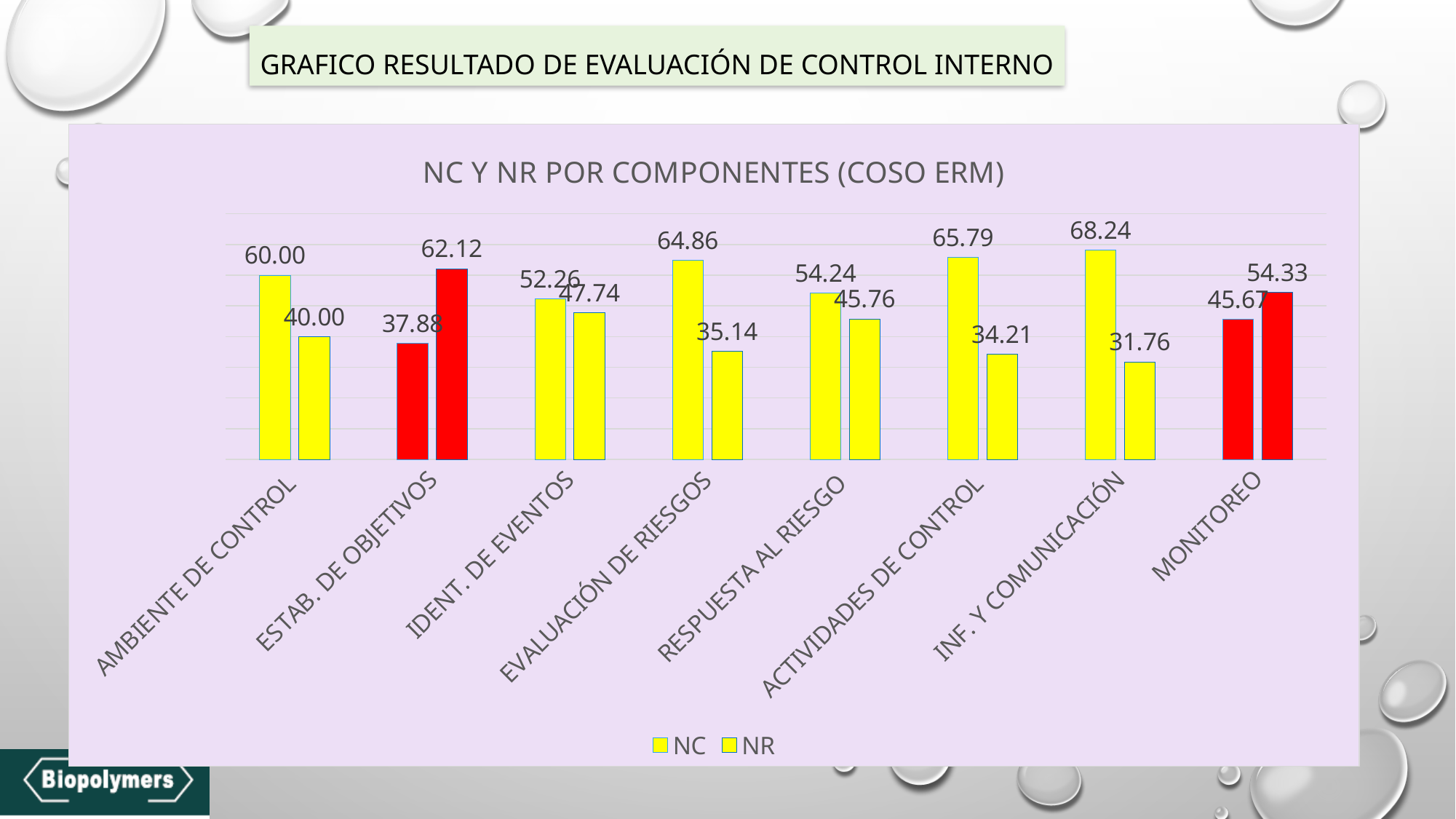
What is the NC value for MONITOREO? 45.67 Which component has the highest NC value? INF. Y COMUNICACIÓN How many components are shown on the x axis? 8 What is the NC value for AMBIENTE DE CONTROL? 60.00 Which component has the lowest NC value? ESTAB. DE OBJETIVOS What is the NR value for INF. Y COMUNICACIÓN? 31.76 Which component has the highest NR value? ESTAB. DE OBJETIVOS How many series does the legend list? 2 What is the NR value for ESTAB. DE OBJETIVOS? 62.12 What is the difference between the NC and NR values for AMBIENTE DE CONTROL? 20.00 Which is larger for MONITOREO, the NC value or the NR value? NR What type of chart is shown? Bar chart